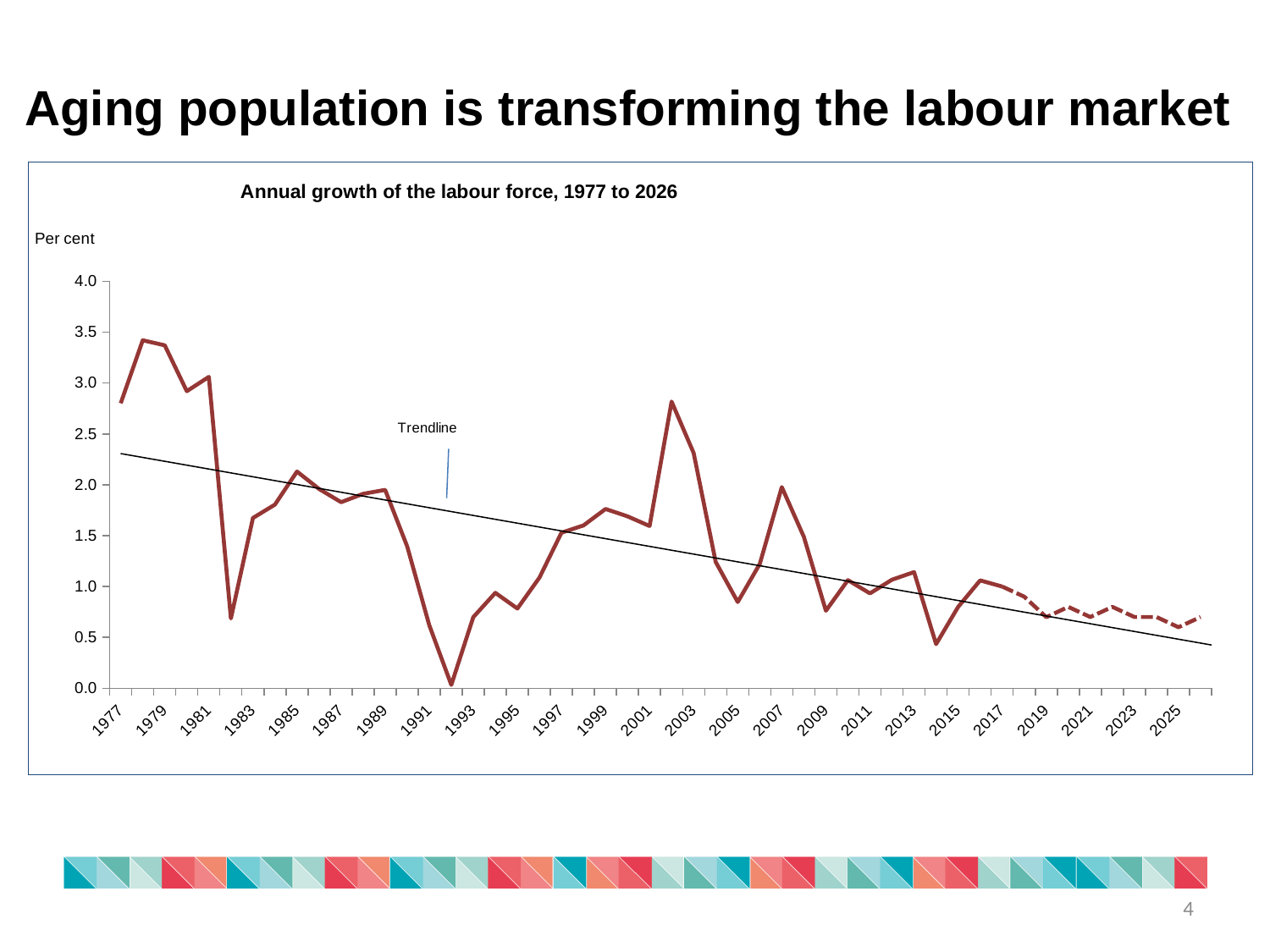
Is the value for 1982 greater or less than 1.0? less Is the value for 2014 greater or less than 0.5? less What kind of chart is shown on the slide? line chart Which year has the lowest annual growth of the labour force? 1992 Is the value for 2002 greater or less than 2.5? greater What unit is shown on the vertical axis of the chart? Per cent Does the trendline rise or fall from 1977 to 2026? fall Which year has the higher annual growth, 1978 or 2002? 1978 What is the title of the chart? Annual growth of the labour force, 1977 to 2026 Which year has the higher annual growth, 2002 or 2007? 2002